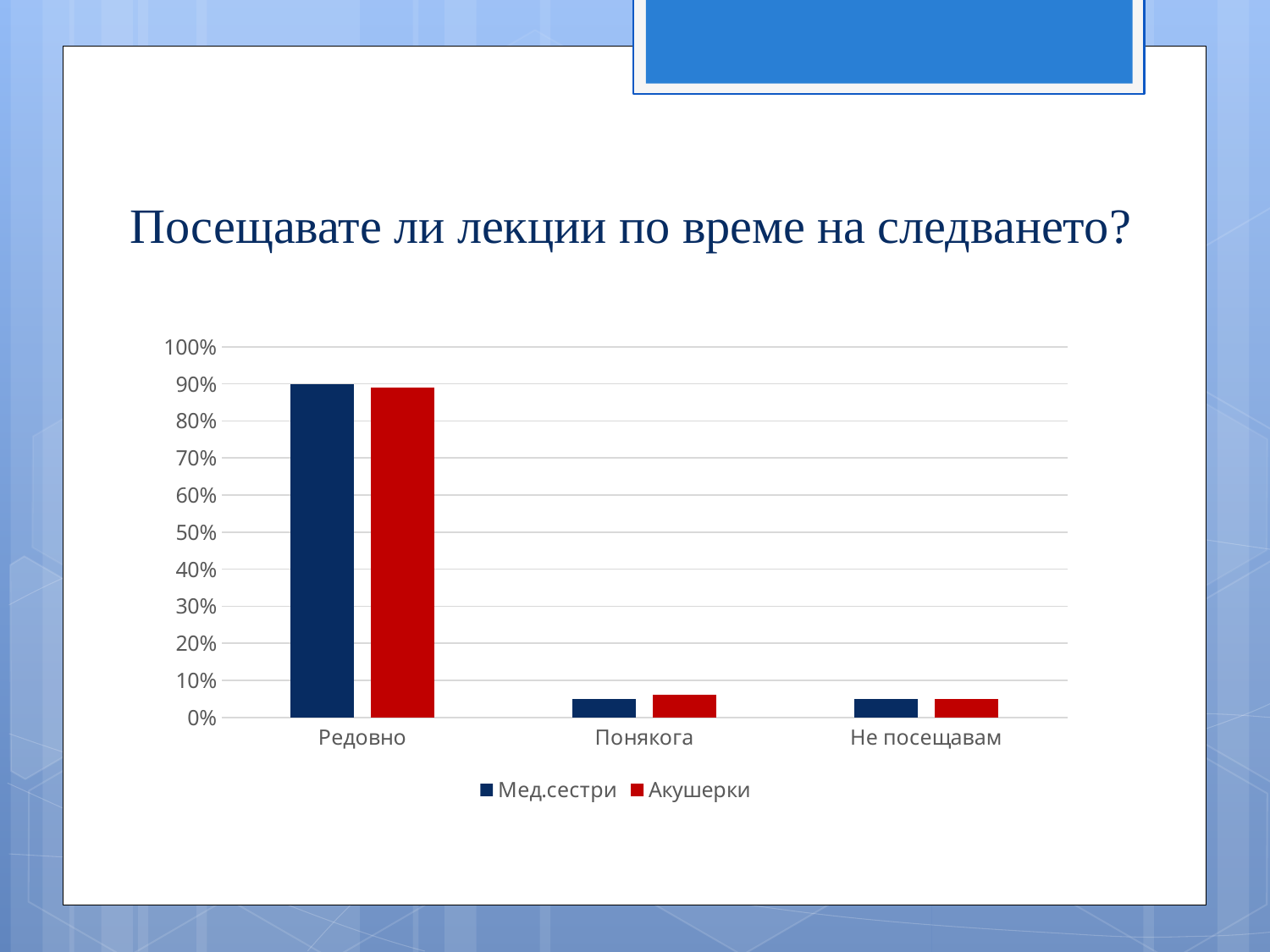
What is the value for Мед.сестри in the Редовно category? 90% How many categories are shown on the x axis? 3 For Мед.сестри, which is larger: the value for Редовно or the value for Понякога? Редовно Which colour represents the Акушерки series in the legend? red How many series does the legend list? 2 What is the title of the chart? Посещавате ли лекции по време на следването? What kind of chart is shown on the slide? bar chart Which category has the highest value for Акушерки? Редовно Is the value for Акушерки in the Не посещавам category greater or less than 10%? less Is the value for Акушерки in the Редовно category greater or less than 80%? greater Is the value for Мед.сестри in the Понякога category greater or less than 10%? less Which category has the highest value for Мед.сестри? Редовно